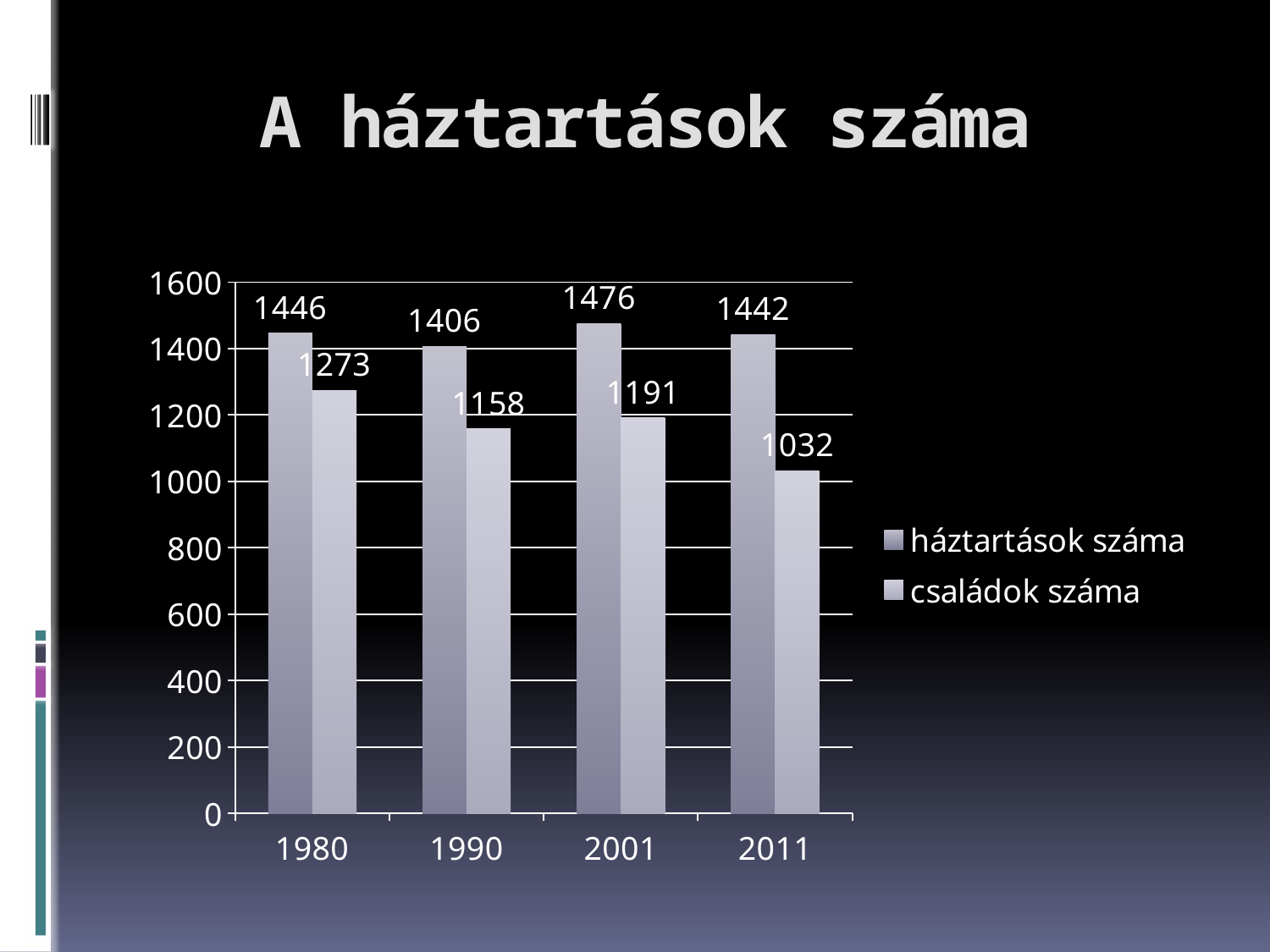
In which year is családok száma lowest? 2011 Is the value for családok száma in 2011 greater or less than 1200? less What is the difference between háztartások száma and családok száma in 2011? 410 What is the difference between családok száma in 1980 and in 1990? 115 How many series does the legend list? 2 In which year is háztartások száma highest? 2001 What is the value of háztartások száma in 1980? 1446 What kind of chart is shown on the slide? bar chart What is the value of családok száma in 2011? 1032 How many years are shown on the x axis? 4 What is the value of családok száma in 1990? 1158 Which is larger: családok száma in 2001 or családok száma in 1990? 2001